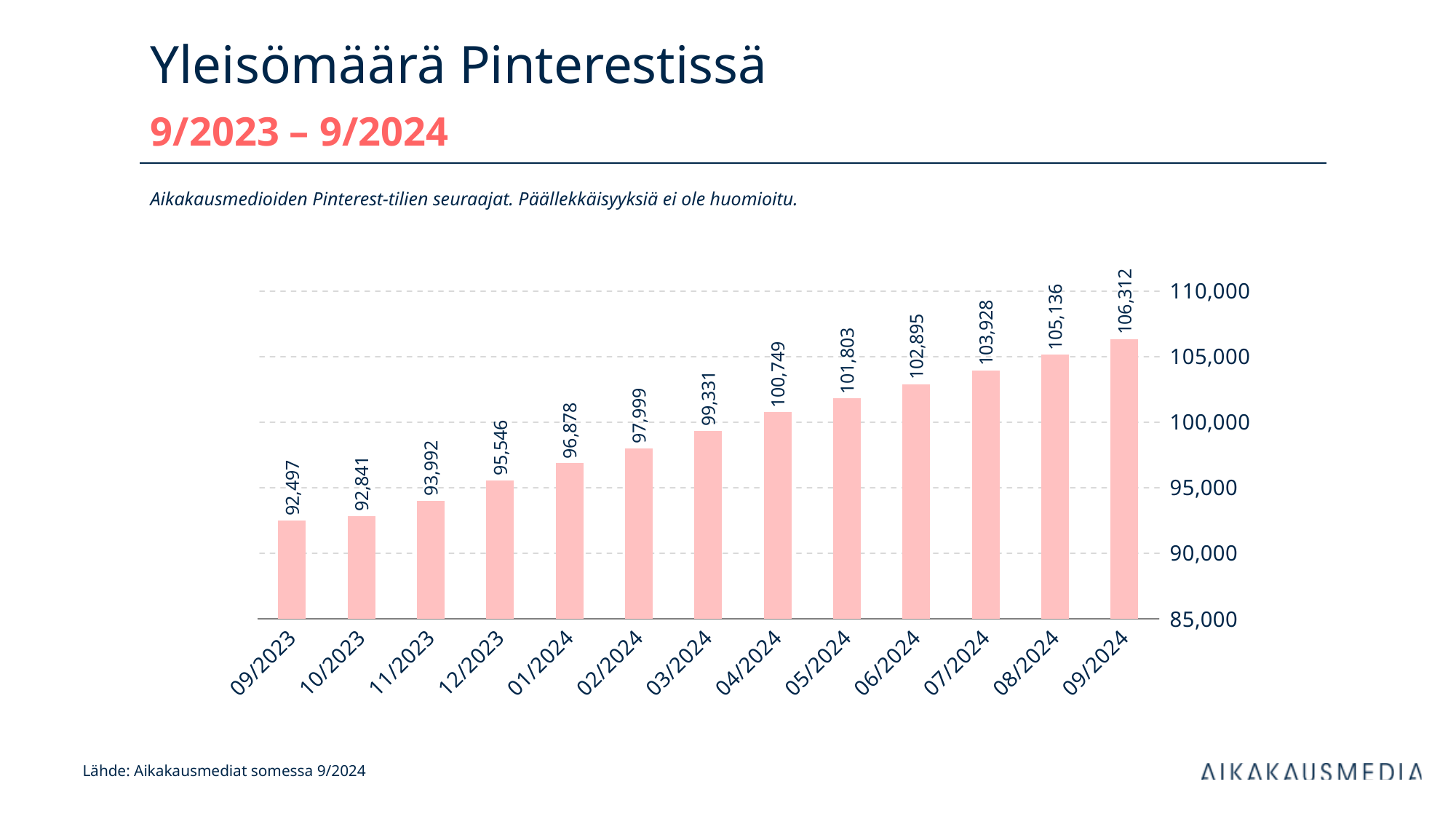
What is the difference between the values for 09/2024 and 09/2023? 13,815 What is the value for 09/2023? 92,497 What is the value for 03/2024? 99,331 What is the difference between the values for 08/2024 and 07/2024? 1,208 What kind of chart is shown on the slide? bar chart Which month has the lowest value? 09/2023 What is the value for 09/2024? 106,312 Is the value for 05/2024 greater or less than 100,000? greater How many months are shown on the x axis? 13 Do the values rise or fall from 09/2023 to 09/2024? rise Which is larger, the value for 12/2023 or the value for 04/2024? 04/2024 Which month has the highest value? 09/2024